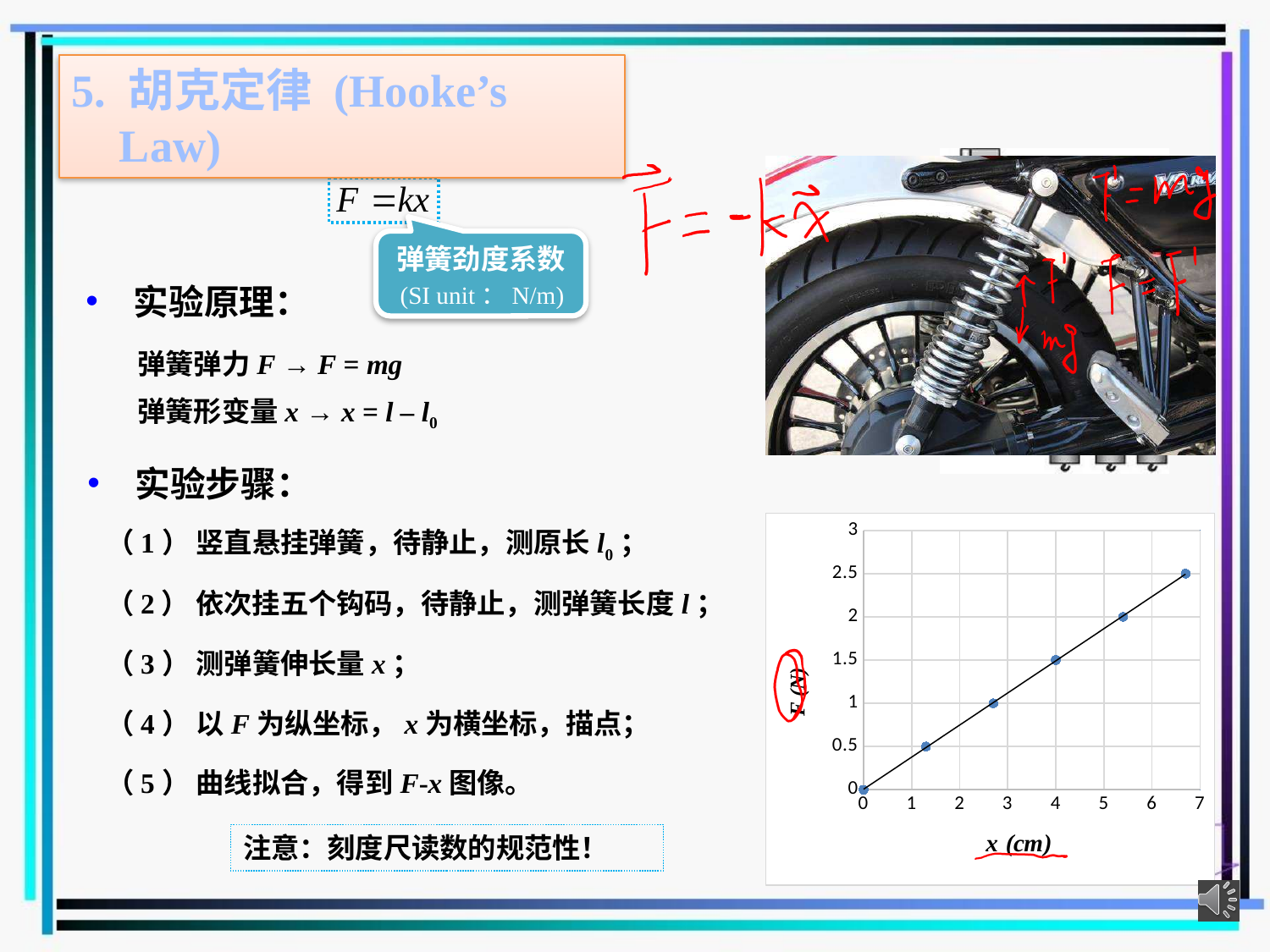
What kind of chart is shown on the slide? scatter chart What is the label of the vertical axis of the chart? F (N) What is the lowest F value plotted on the chart? 0 What is the label of the horizontal axis of the chart? x (cm) Is the x value of the rightmost plotted point greater or less than 6? greater Is the F value of the second plotted point (the one just after the origin) greater or less than 1? less Do the plotted F values rise or fall as x increases? rise What is the highest F value plotted on the chart? 2.5 Which plotted point has the larger F value: the rightmost point or the point nearest x = 4? the rightmost point Is the F value of the rightmost plotted point greater or less than 2? greater How many data points are plotted on the chart? 6 What is the maximum value shown on the vertical axis of the chart? 3